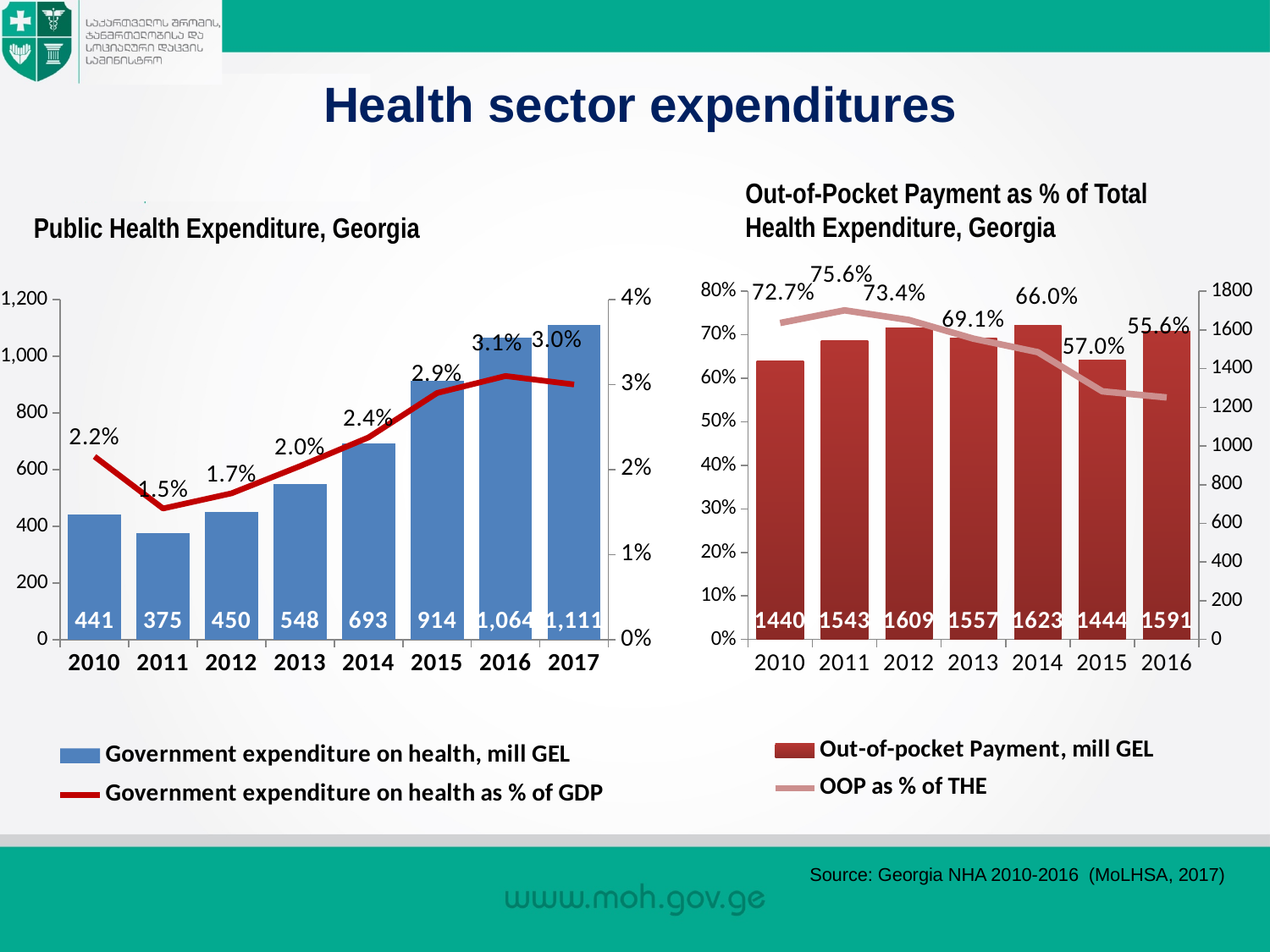
In the 'Out-of-Pocket Payment as % of Total Health Expenditure, Georgia' chart, which year had the highest OOP as % of THE? 2011 In the 'Public Health Expenditure, Georgia' chart, what was government expenditure on health in mill GEL in 2015? 914 In the 'Public Health Expenditure, Georgia' chart, which year had the highest government expenditure on health as % of GDP? 2016 In the 'Public Health Expenditure, Georgia' chart, what was government expenditure on health as % of GDP in 2014? 2.4% In the 'Public Health Expenditure, Georgia' chart, how many years are shown on the x axis? 8 In the 'Out-of-Pocket Payment as % of Total Health Expenditure, Georgia' chart, what was out-of-pocket payment in mill GEL in 2014? 1623 In the 'Out-of-Pocket Payment as % of Total Health Expenditure, Georgia' chart, which is larger: out-of-pocket payment in mill GEL in 2012 or in 2015? 2012 In the 'Out-of-Pocket Payment as % of Total Health Expenditure, Georgia' chart, what was OOP as % of THE in 2016? 55.6% In the 'Public Health Expenditure, Georgia' chart, which year had the lowest government expenditure on health in mill GEL? 2011 In the 'Out-of-Pocket Payment as % of Total Health Expenditure, Georgia' chart, does OOP as % of THE rise or fall from 2011 to 2016? fall In the 'Public Health Expenditure, Georgia' chart, by how much did government expenditure on health in mill GEL increase from 2016 to 2017? 47 How many series does the legend of the 'Out-of-Pocket Payment as % of Total Health Expenditure, Georgia' chart list? 2